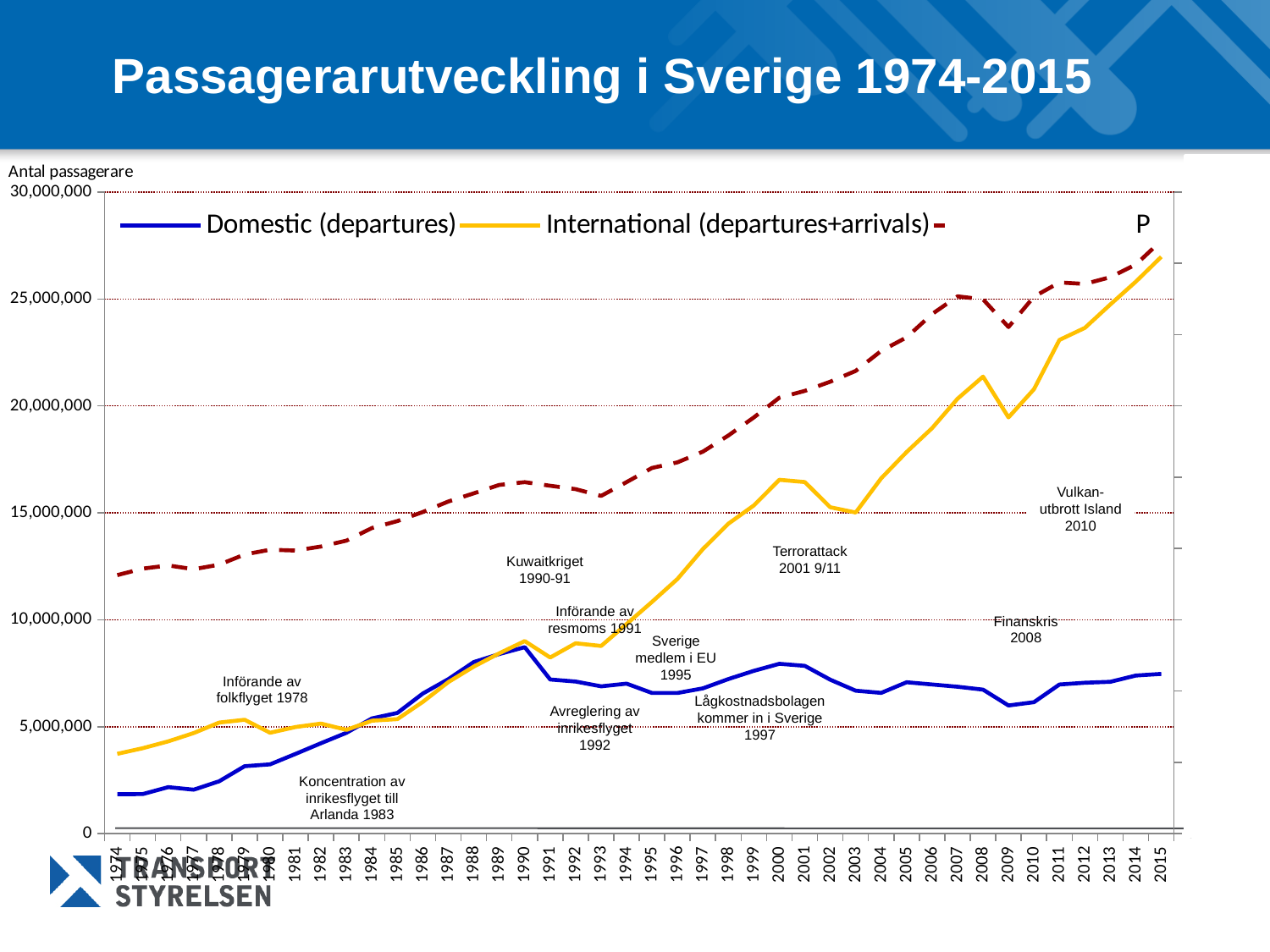
What kind of chart is shown on the slide? line chart Is the value for International (departures+arrivals) in 2008 greater or less than 20,000,000? greater How many years are plotted along the x axis? 42 How many series does the legend list? 3 What colour is the line for the Domestic (departures) series? blue Does the International (departures+arrivals) series generally rise or fall from 1974 to 2015? rise What is the title of the chart on the slide? Passagerarutveckling i Sverige 1974-2015 Is the value for International (departures+arrivals) in 2015 greater or less than 25,000,000? greater In which year does the International (departures+arrivals) series reach its highest value? 2015 Is the value for Domestic (departures) in 2015 greater or less than 10,000,000? less In 2015, which series is larger: Domestic (departures) or International (departures+arrivals)? International (departures+arrivals)